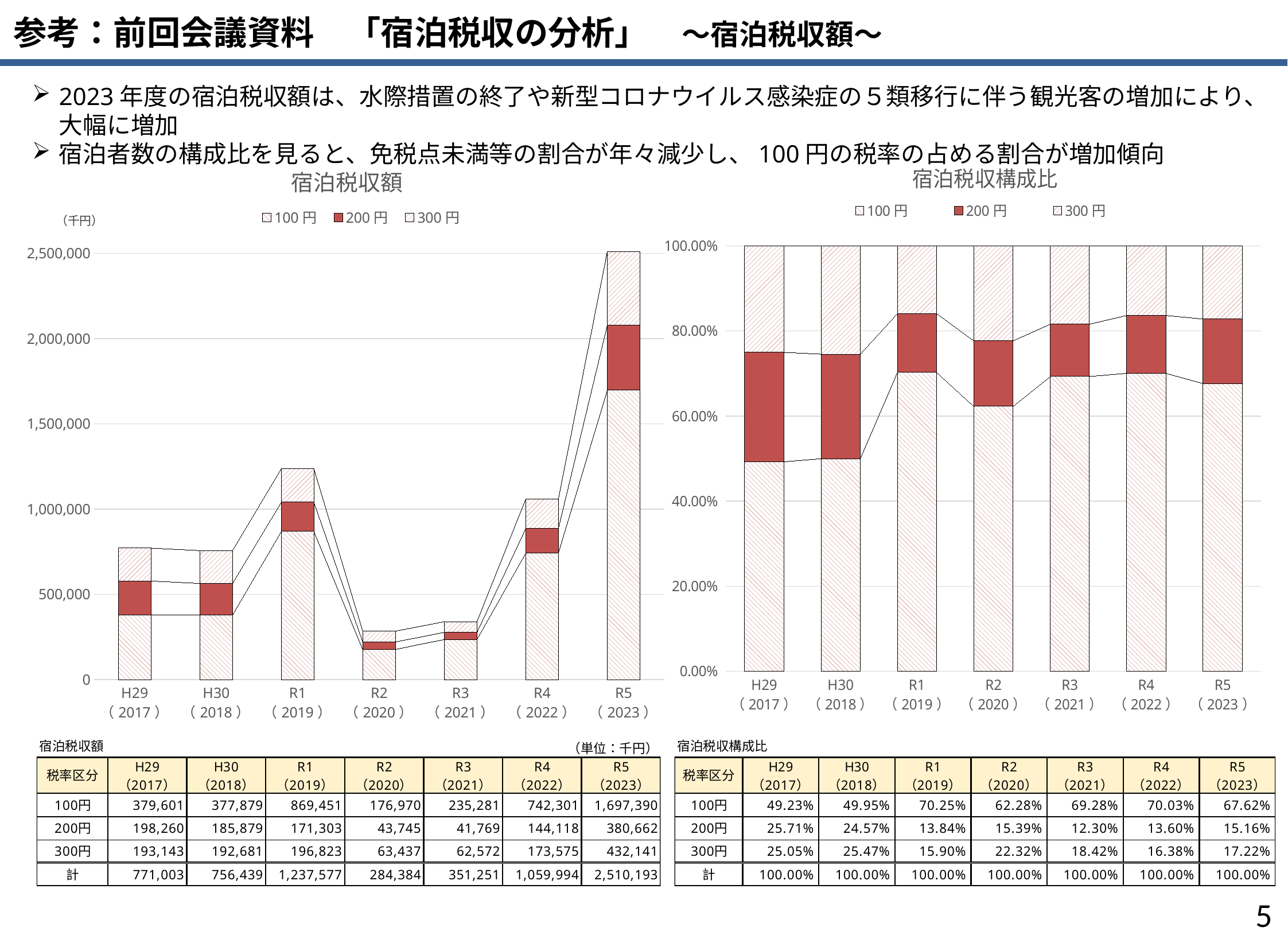
In the 宿泊税収額 chart, what is the total of the stacked bar for R1 (2019)? 1,237,577 In the 宿泊税収構成比 chart, is the 300円 share for R2 (2020) larger or smaller than the 300円 share for R3 (2021)? larger In the 宿泊税収額 chart, what is the difference between the 200円 values for R4 (2022) and R3 (2021)? 102,349 In the 宿泊税収額 chart, how many series does the legend list? 3 In the 宿泊税収構成比 chart, what is the share of 100円 in H29 (2017)? 49.23% In the 宿泊税収額 chart, is the total for R4 (2022) greater or less than 1,000,000? greater In the 宿泊税収額 chart, what is the value for 100円 in R5 (2023)? 1,697,390 How many years are shown on the x axis of the 宿泊税収額 chart? 7 What kind of chart is the 宿泊税収構成比 chart? Stacked bar chart In the 宿泊税収構成比 chart, which year has the highest share for 100円? R1 (2019) In the 宿泊税収額 chart, which year has the highest total? R5 (2023) In the 宿泊税収額 chart, which year has the lowest total? R2 (2020)